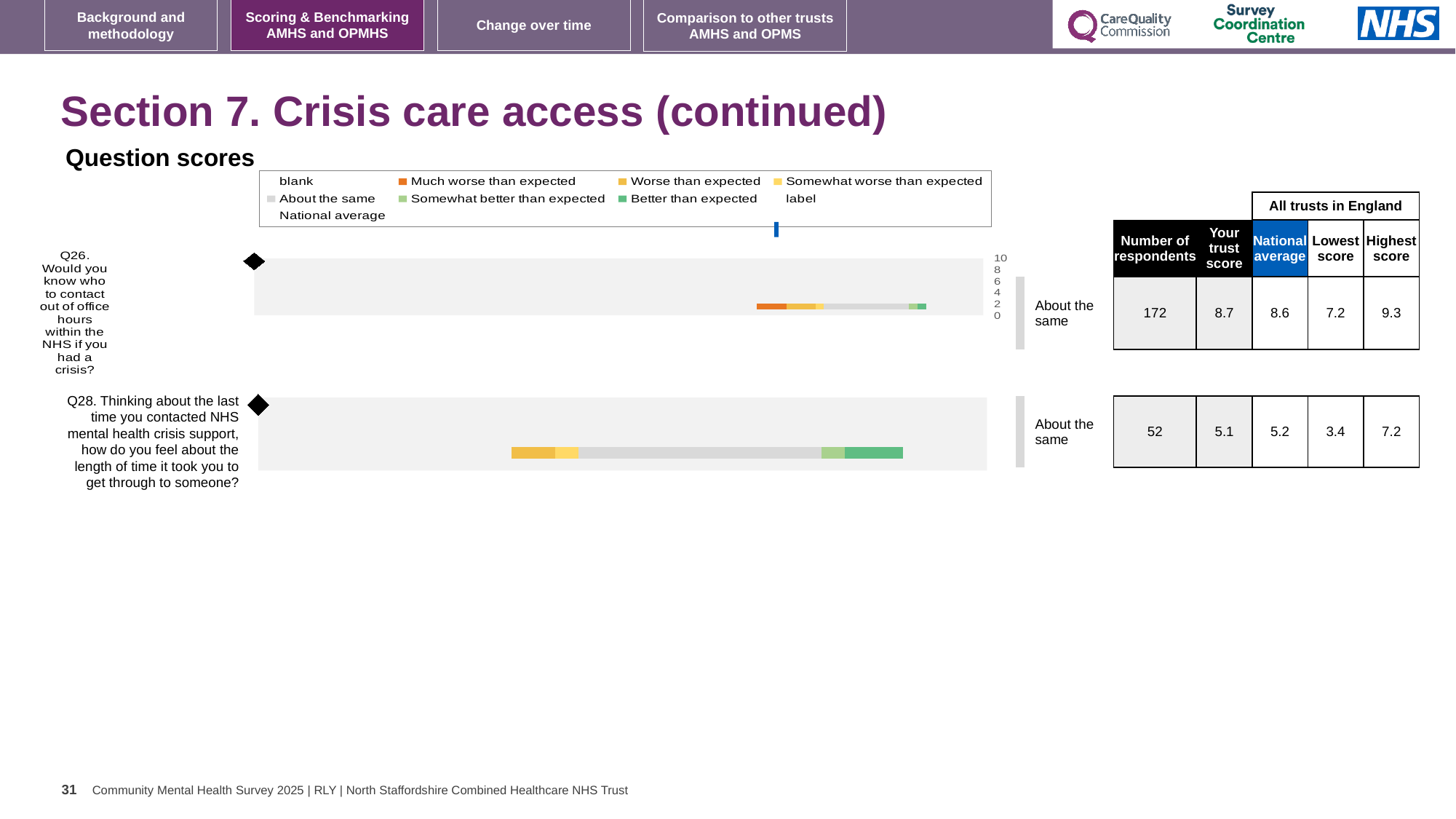
In the legend of the question scores chart, which colour represents 'Much worse than expected'? orange What is the difference between the trust scores for Q26 and Q28? 3.6 How many entries does the legend of the question scores chart list? 9 What is the highest value shown on the axis of the question scores chart? 10 Which benchmark category is shown for Q28 in the question scores chart? About the same How many respondents answered Q28? 52 Which benchmark category is shown for Q26 in the question scores chart? About the same Which question has the higher trust score, Q26 or Q28? Q26 How many questions are plotted in the question scores chart? 2 What is the trust score for Q28 shown next to the question scores chart? 5.1 What is the trust score for Q26 shown next to the question scores chart? 8.7 What kind of chart is used to show the question scores on this slide? bar chart